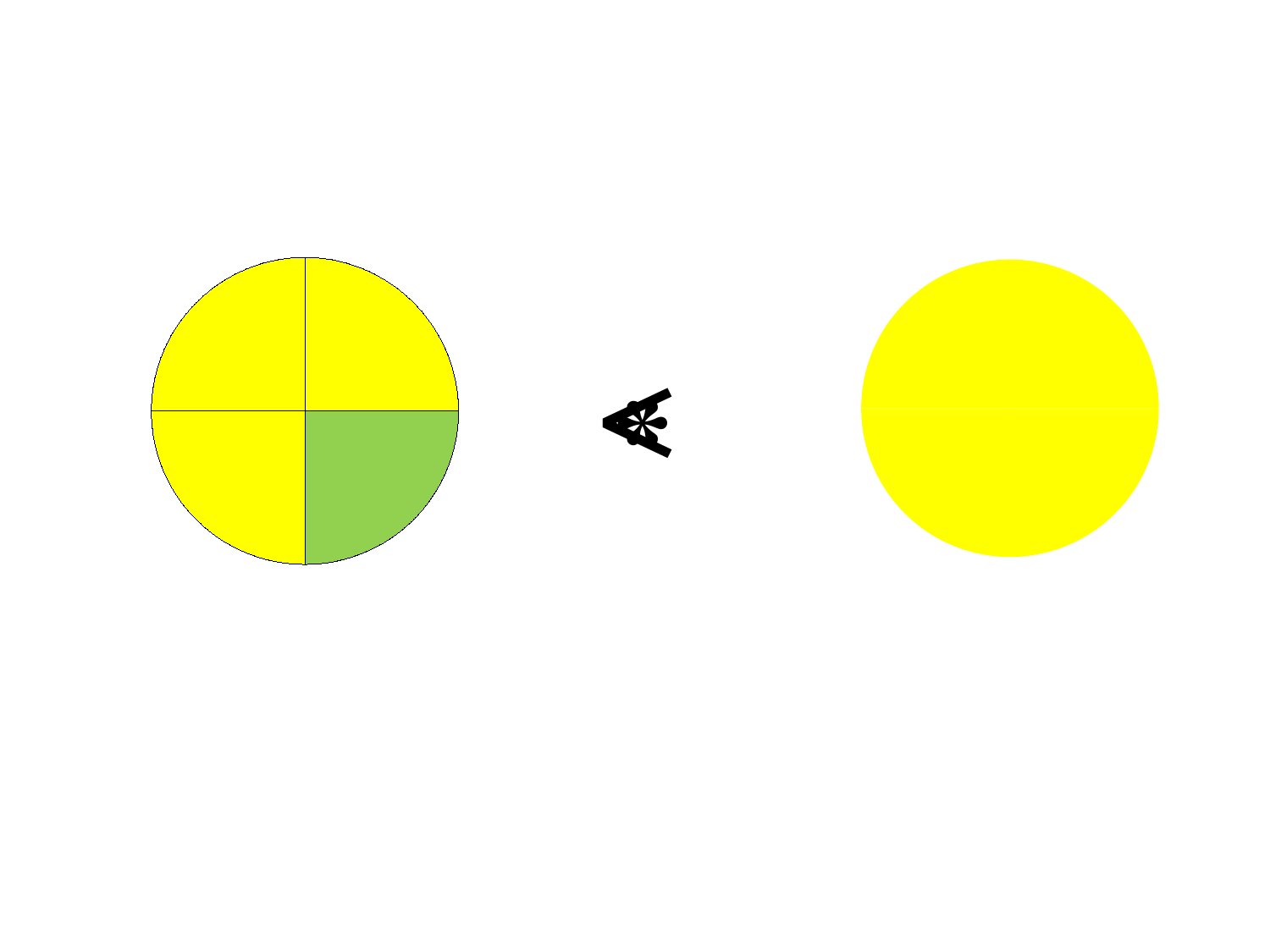
How many slices does the pie chart on the left of the slide have? 4 What kind of chart is the chart on the left of the slide? pie chart In the pie chart on the left of the slide, which colour covers more of the pie, yellow or green? yellow In the pie chart on the left of the slide, what colour is the slice that differs from the others? green What colour are the slices of the pie chart on the right of the slide? yellow In the pie chart on the left of the slide, how many slices are green? 1 What kind of chart is the chart on the right of the slide? pie chart